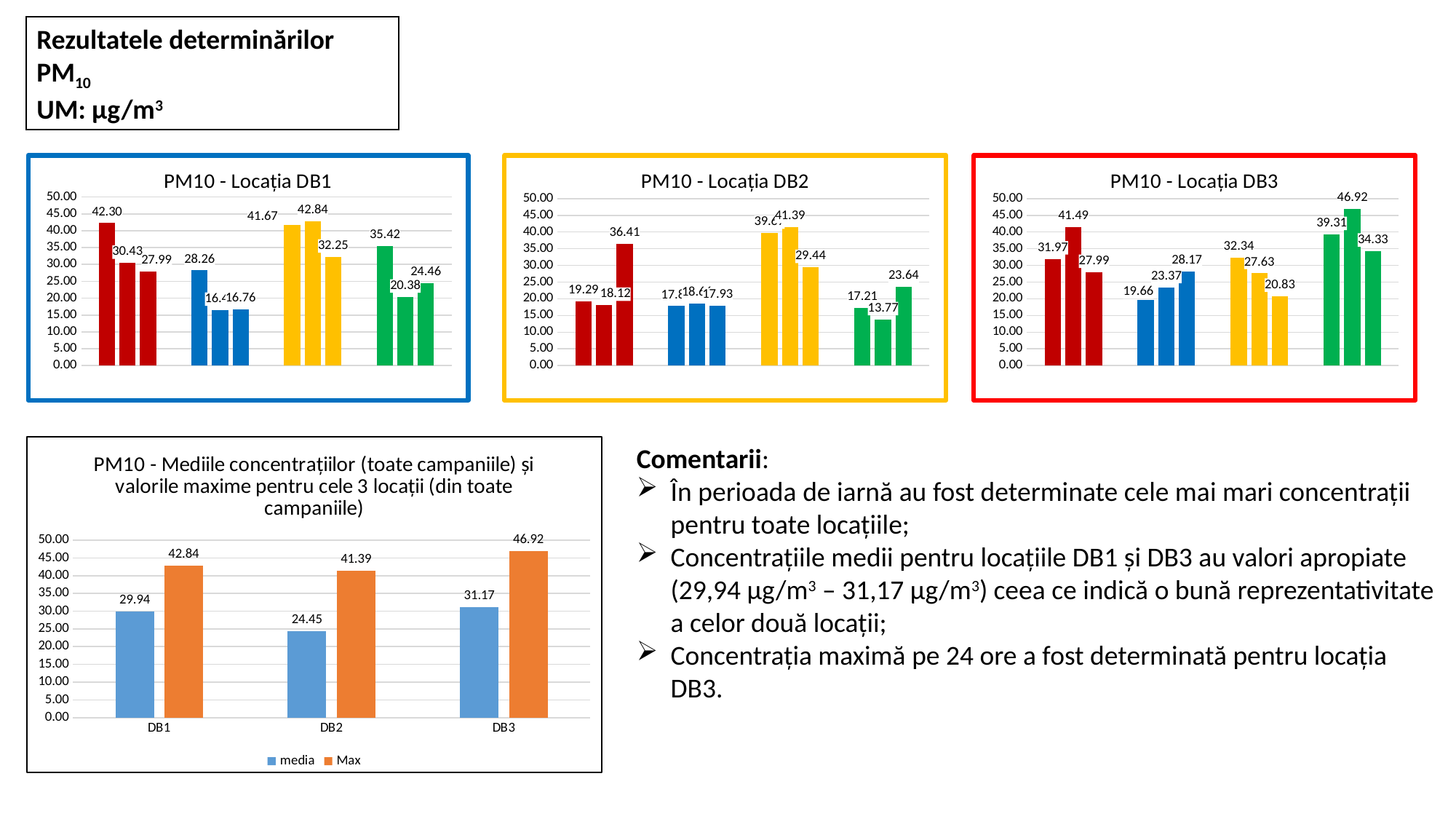
In the bottom-left chart, which location has the highest 'Max' value? DB3 In the chart titled 'PM10 - Mediile concentrațiilor (toate campaniile) și valorile maxime pentru cele 3 locații', what is the 'media' value for DB1? 29.94 What kind of chart is 'PM10 - Locația DB1'? Bar chart In the bottom-left chart, which is larger: the 'media' value for DB1 or the 'media' value for DB3? DB3 In the bottom-left chart, what is the 'Max' value for DB2? 41.39 In the chart titled 'PM10 - Locația DB2', what is the lowest value labelled on a bar? 13.77 How many locations are shown on the x axis of the bottom-left chart? 3 In the chart titled 'PM10 - Locația DB3', what is the highest value labelled on a bar? 46.92 How many series does the legend of the bottom-left chart list? 2 In the bottom-left chart, what is the difference between the 'Max' and 'media' values for DB3? 15.75 In the bottom-left chart, what is the 'media' value for DB3? 31.17 In the bottom-left chart, which location has the lowest 'media' value? DB2